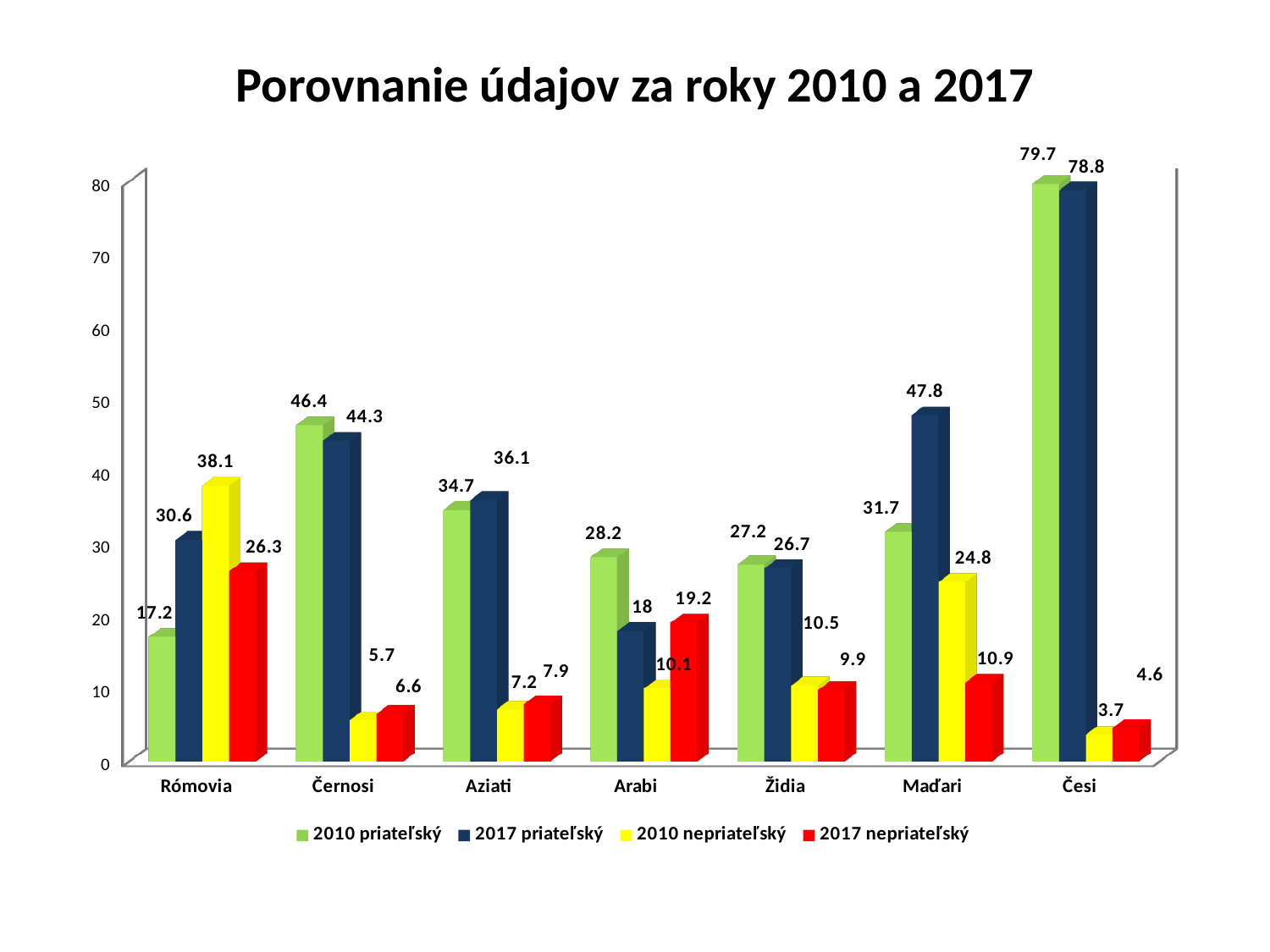
Which category has the highest value in the 2010 priateľský series? Česi How many categories are shown on the x axis? 7 Which category has the lowest value in the 2010 nepriateľský series? Česi How many series does the legend list? 4 Which colour represents the 2017 nepriateľský series? Red What kind of chart is shown on the slide? Bar chart What is the value of the 2010 nepriateľský series for Rómovia? 38.1 Which is larger for Arabi: the 2010 priateľský value or the 2017 priateľský value? 2010 priateľský What is the title of the chart? Porovnanie údajov za roky 2010 a 2017 What is the difference between the 2017 priateľský and 2010 priateľský values for Rómovia? 13.4 What is the value of the 2017 nepriateľský series for Arabi? 19.2 What is the value of the 2017 priateľský series for Maďari? 47.8